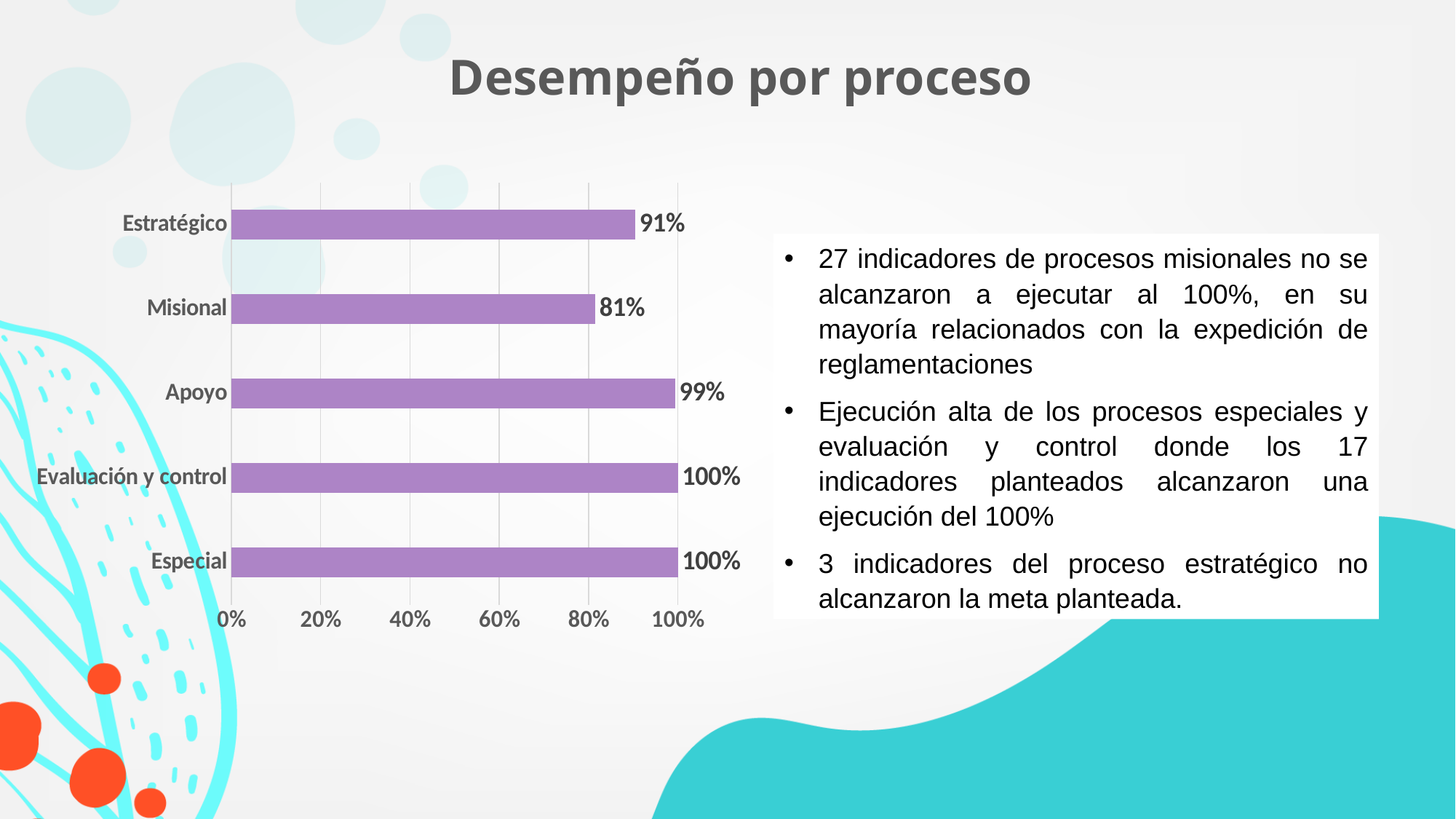
What is the value for Estratégico? 91% How many categories are shown in the chart? 5 What is the value for Misional? 81% What is the title of the slide containing the chart? Desempeño por proceso What is the value for Apoyo? 99% What is the difference between the values for Apoyo and Misional? 18% Which category has the lowest value? Misional Is the value for Misional greater or less than 100%? less Which is larger, the value for Estratégico or the value for Misional? Estratégico What kind of chart is shown on the slide? bar chart What is the difference between the values for Estratégico and Misional? 10% What is the value for Evaluación y control? 100%